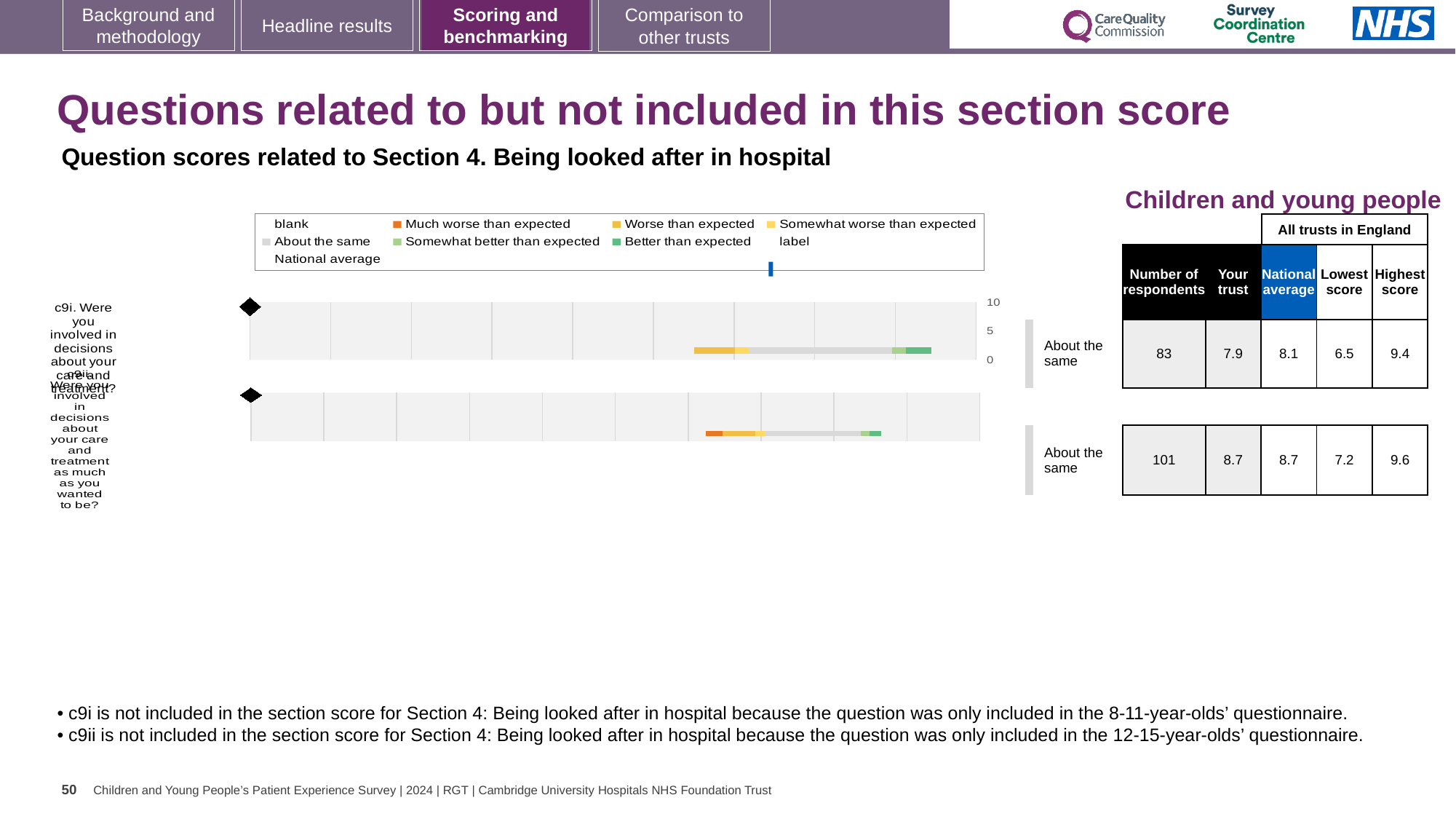
What benchmark category is shown next to the bar for question c9ii? About the same Which question has the higher number of respondents, c9i or c9ii? c9ii What kind of chart is used to show the question scores for c9i and c9ii? bar chart What is the 'Your trust' score for question c9i? 7.9 For question c9i, which is larger: the 'Your trust' score or the national average? National average Which question has the lower lowest score, c9i or c9ii? c9i How many questions are plotted in the chart? 2 What is the highest score among all trusts in England for question c9i? 9.4 What is the maximum value shown on the chart's score axis? 10 What is the difference between the highest and lowest scores for question c9i? 2.9 How many respondents answered question c9ii? 101 What is the national average score for question c9ii? 8.7